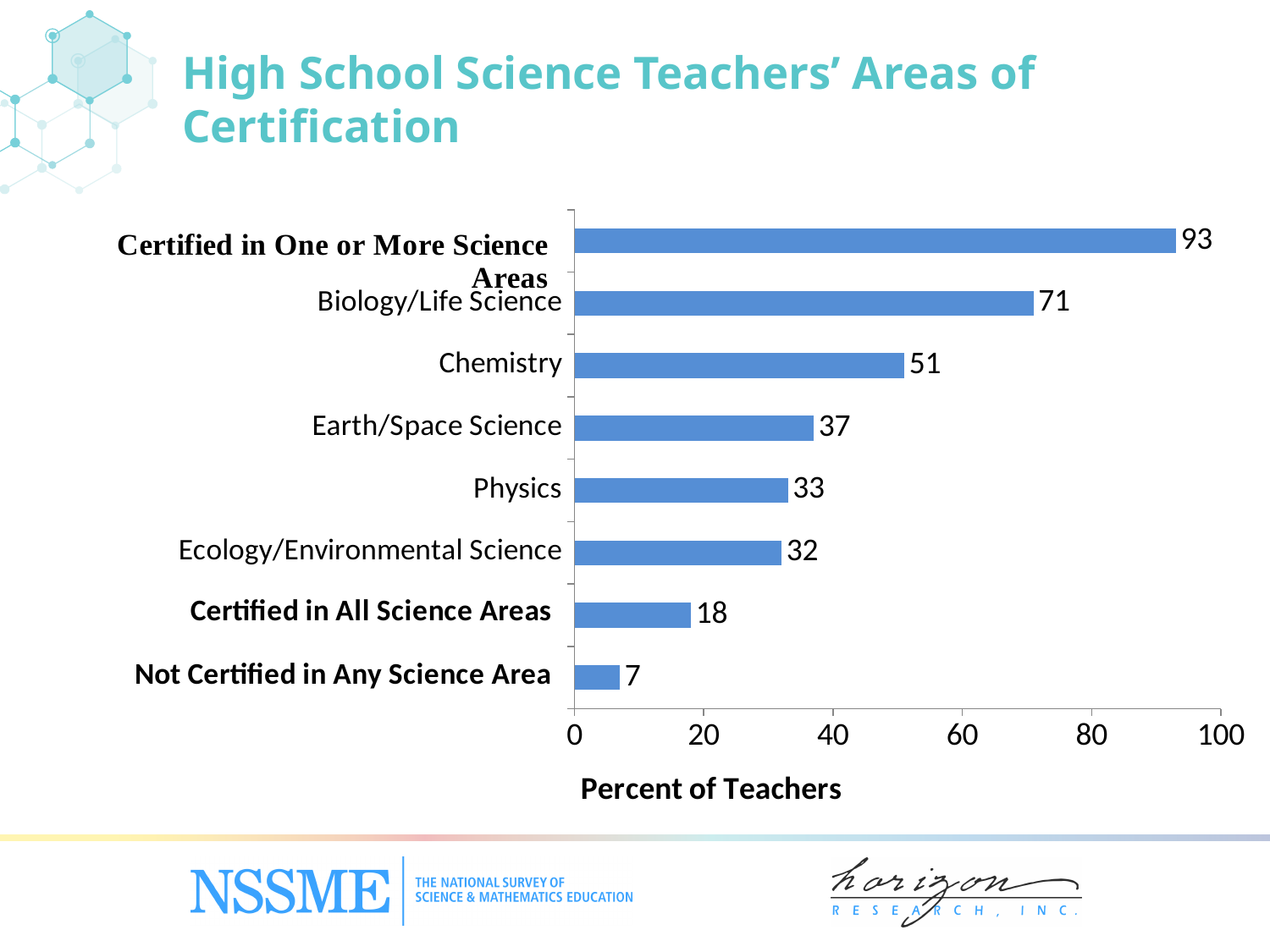
How many categories are shown in the chart? 8 What percent of teachers are Not Certified in Any Science Area? 7 What is the value for Chemistry? 51 Which is larger, the value for Earth/Space Science or the value for Physics? Earth/Space Science Which category has the highest value? Certified in One or More Science Areas What is the value for Certified in All Science Areas? 18 What is the difference between the values for Biology/Life Science and Chemistry? 20 What percent of teachers are certified in Biology/Life Science? 71 What is the label of the horizontal axis? Percent of Teachers What kind of chart is shown on the slide? bar chart Is the value for Ecology/Environmental Science greater or less than 40? less Which category has the lowest value? Not Certified in Any Science Area